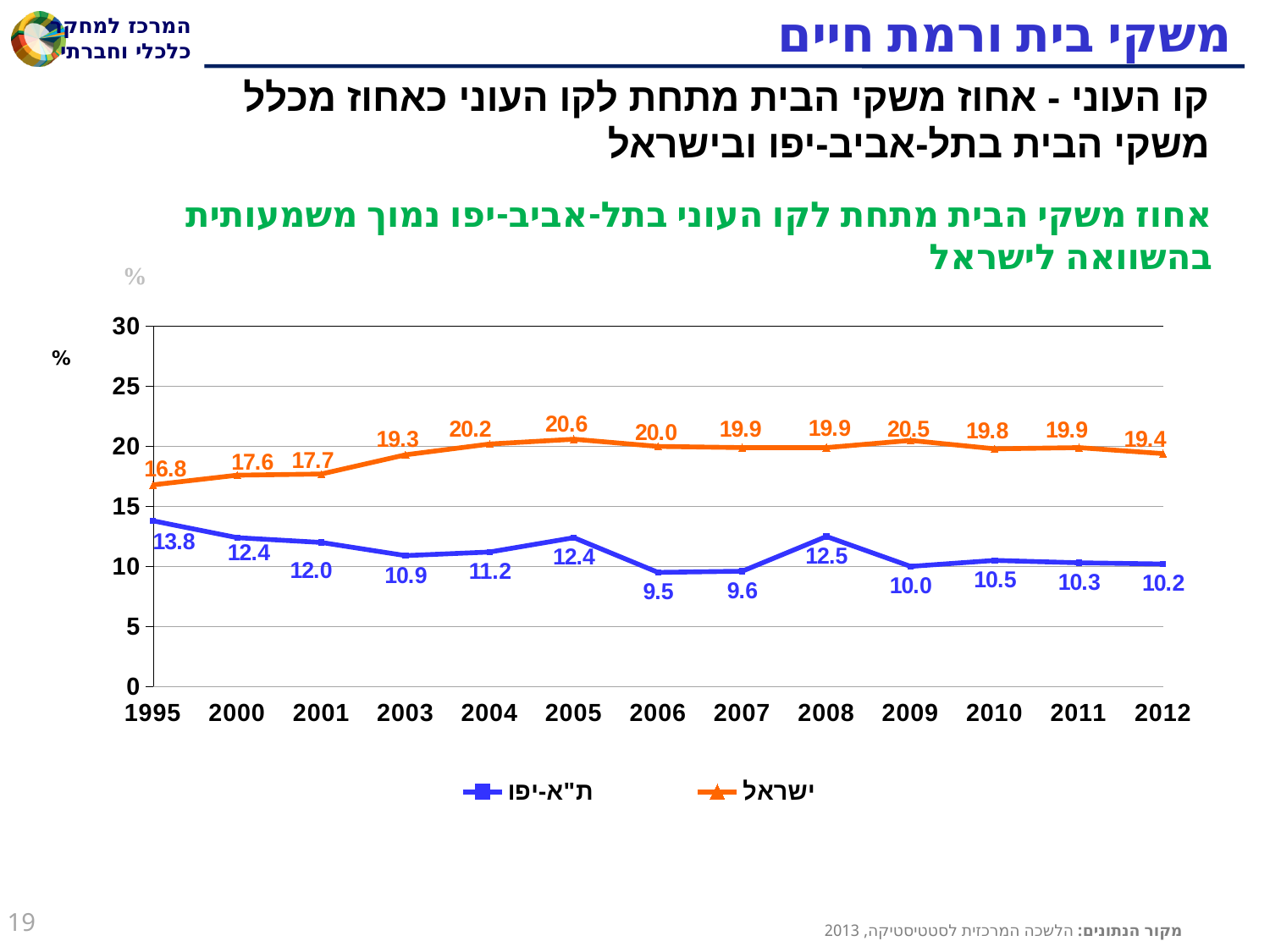
How many years are shown on the x axis? 13 Is the value for ישראל in 1995 greater or less than 15? greater In which year is the ישראל series at its highest? 2005 How many series does the legend list? 2 What kind of chart is shown on the slide? line chart What is the value for ת"א-יפו in 1995? 13.8 What is the value for ת"א-יפו in 2012? 10.2 Which colour is used for the ישראל series? orange In which year is the ת"א-יפו series at its lowest? 2006 What is the value for ישראל in 2005? 20.6 What is the difference between the ישראל and ת"א-יפו values in 2012? 9.2 Which series has the larger value in 2008, ישראל or ת"א-יפו? ישראל